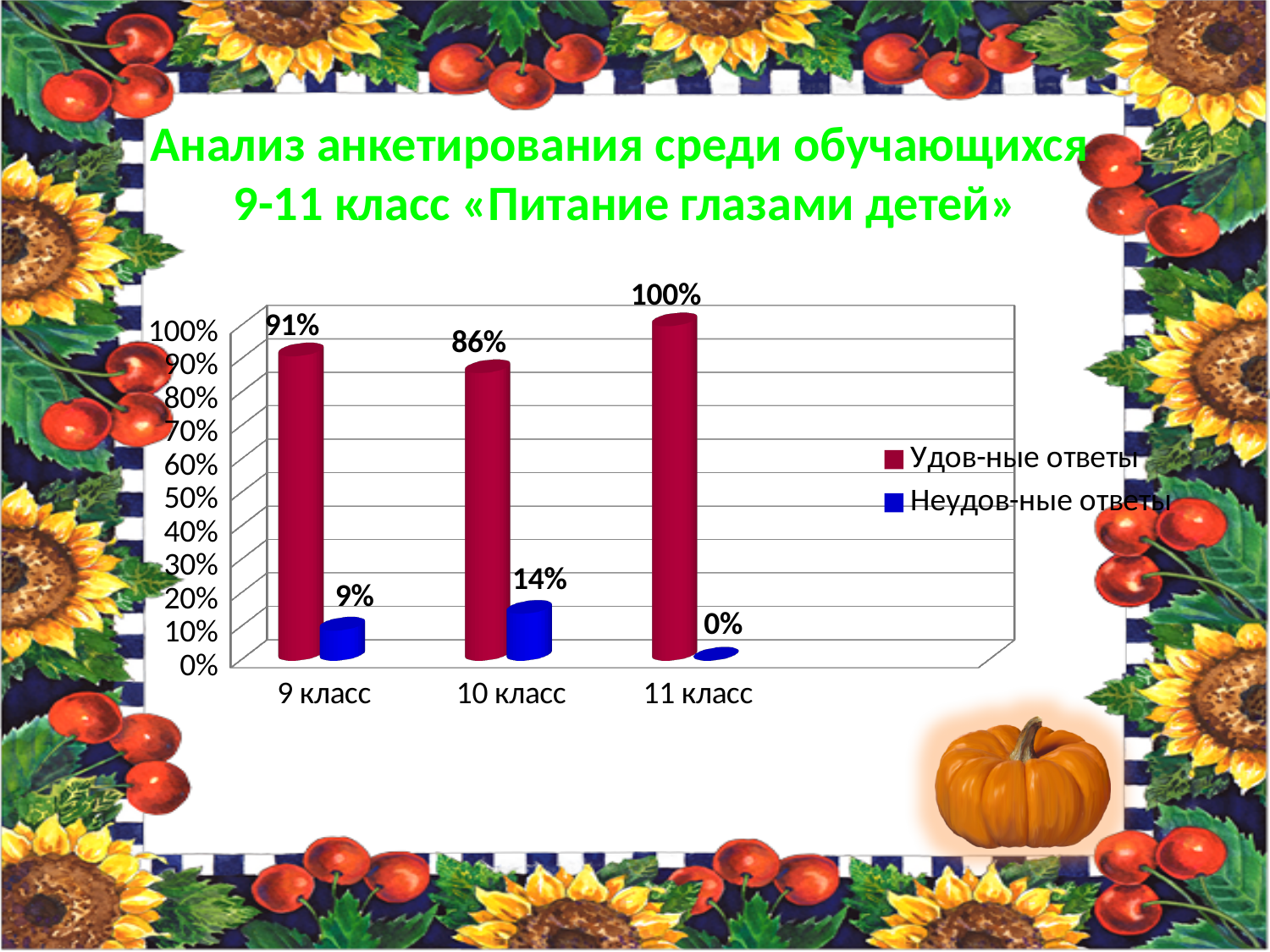
Which class has the highest value for Удов-ные ответы? 11 класс What is the value for Неудов-ные ответы in 10 класс? 14% What kind of chart is shown on the slide? Bar chart What is the value for Удов-ные ответы in 11 класс? 100% What is the difference between Удов-ные ответы and Неудов-ные ответы in 9 класс? 82% What is the value for Удов-ные ответы in 9 класс? 91% What is the value for Неудов-ные ответы in 11 класс? 0% Which class has the highest value for Неудов-ные ответы? 10 класс How many series does the legend list? 2 Which class has the lowest value for Удов-ные ответы? 10 класс Which is larger: Удов-ные ответы in 9 класс or Удов-ные ответы in 10 класс? Удов-ные ответы in 9 класс How many classes are shown on the x axis? 3